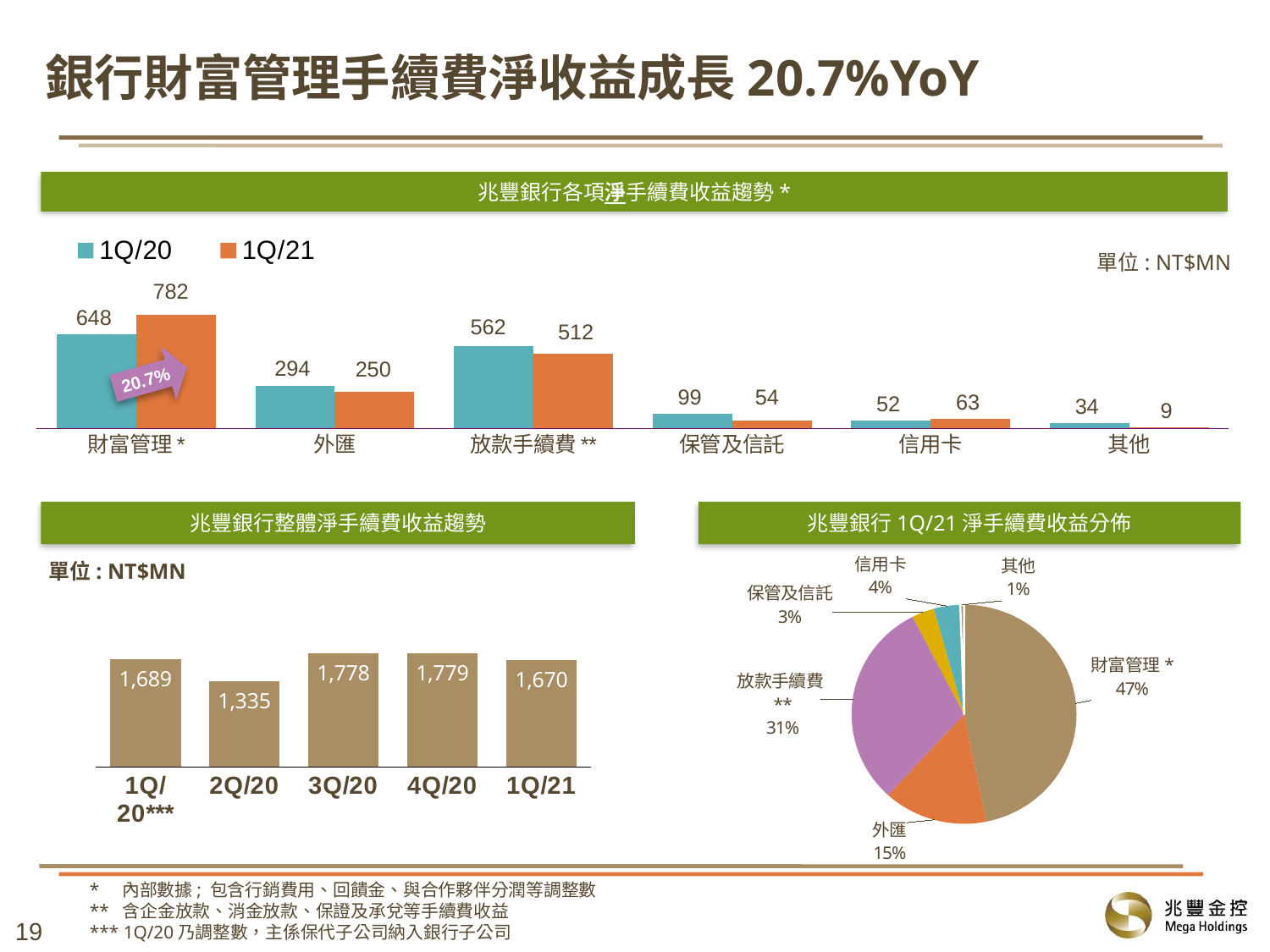
In the top chart (兆豐銀行各項淨手續費收益趨勢), what is the 1Q/20 value for 放款手續費? 562 In the bottom-right pie chart (兆豐銀行 1Q/21 淨手續費收益分佈), what share does 放款手續費 ** have? 31% In the top chart (兆豐銀行各項淨手續費收益趨勢), how many series does the legend list? 2 In the top chart (兆豐銀行各項淨手續費收益趨勢), how many categories are shown on the x axis? 6 In the top chart (兆豐銀行各項淨手續費收益趨勢), which category has the lowest 1Q/21 value? 其他 In the top chart (兆豐銀行各項淨手續費收益趨勢), what is the difference between the 1Q/21 and 1Q/20 values for 外匯? 44 In the bottom-left chart (兆豐銀行整體淨手續費收益趨勢), what is the value for 2Q/20? 1,335 In the bottom-right pie chart (兆豐銀行 1Q/21 淨手續費收益分佈), which slice is the largest? 財富管理 * In the top chart (兆豐銀行各項淨手續費收益趨勢), what is the 1Q/21 value for 財富管理? 782 In the bottom-left chart (兆豐銀行整體淨手續費收益趨勢), which period has the highest value? 4Q/20 In the top chart (兆豐銀行各項淨手續費收益趨勢), is the 1Q/20 or the 1Q/21 value larger for 信用卡? 1Q/21 What kind of chart is the bottom-left chart (兆豐銀行整體淨手續費收益趨勢)? bar chart